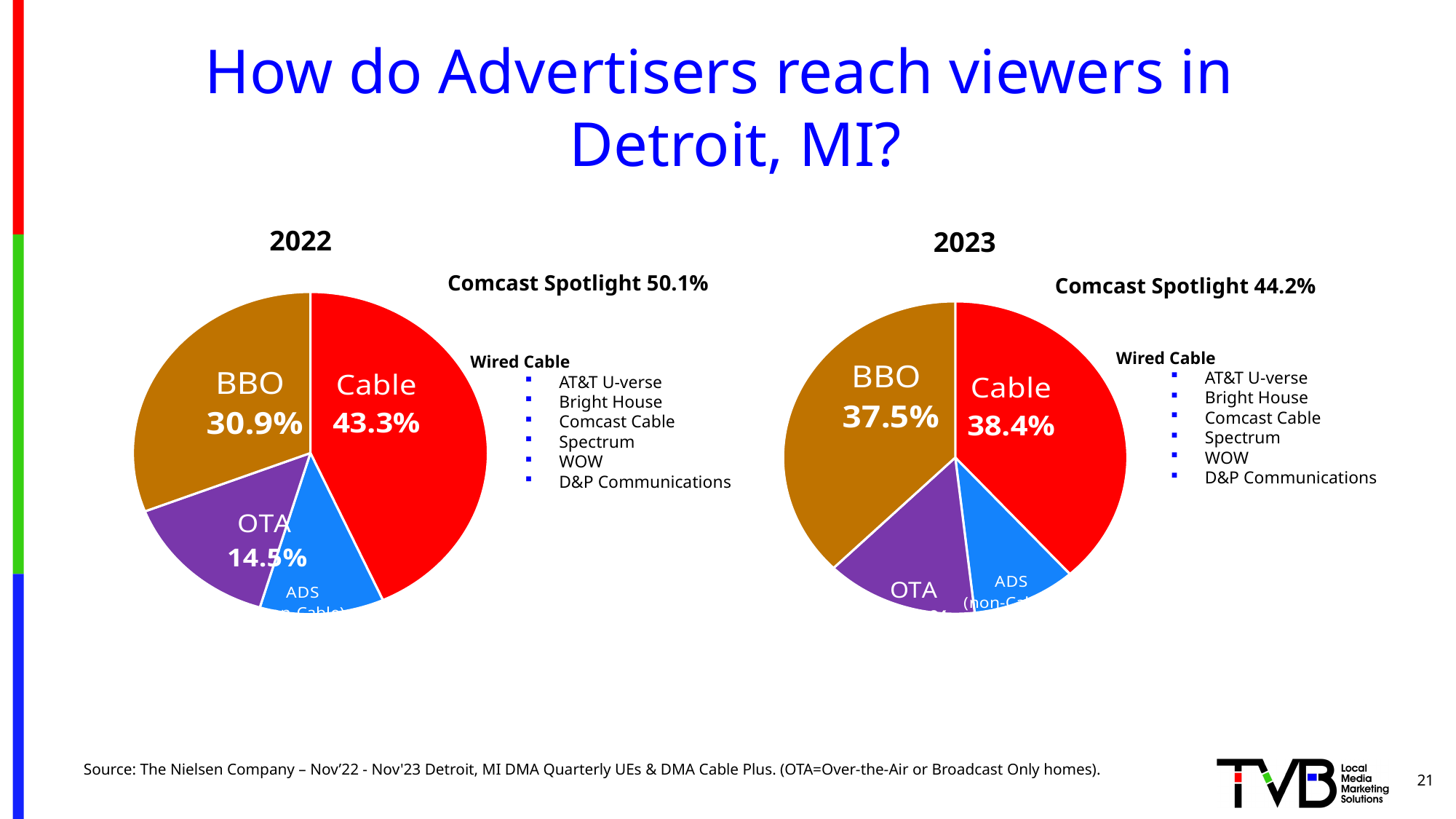
In the 2022 pie chart, what share does BBO have? 30.9% In the 2022 pie chart, which category has the smallest share? ADS In the 2023 pie chart, what share does BBO have? 37.5% In the 2022 pie chart, which category has the largest share? Cable In the 2023 pie chart, what share does Cable have? 38.4% In the 2022 pie chart, what share does Cable have? 43.3% How many slices does the 2022 pie chart have? 4 What kind of chart is used for the 2022 and 2023 data? Pie chart In the 2023 pie chart, which is larger, Cable or BBO? Cable By how many percentage points did BBO's share change from the 2022 chart to the 2023 chart? 6.6 percentage points In the 2022 pie chart, how many percentage points larger is Cable than BBO? 12.4 percentage points In the 2022 pie chart, what share does OTA have? 14.5%